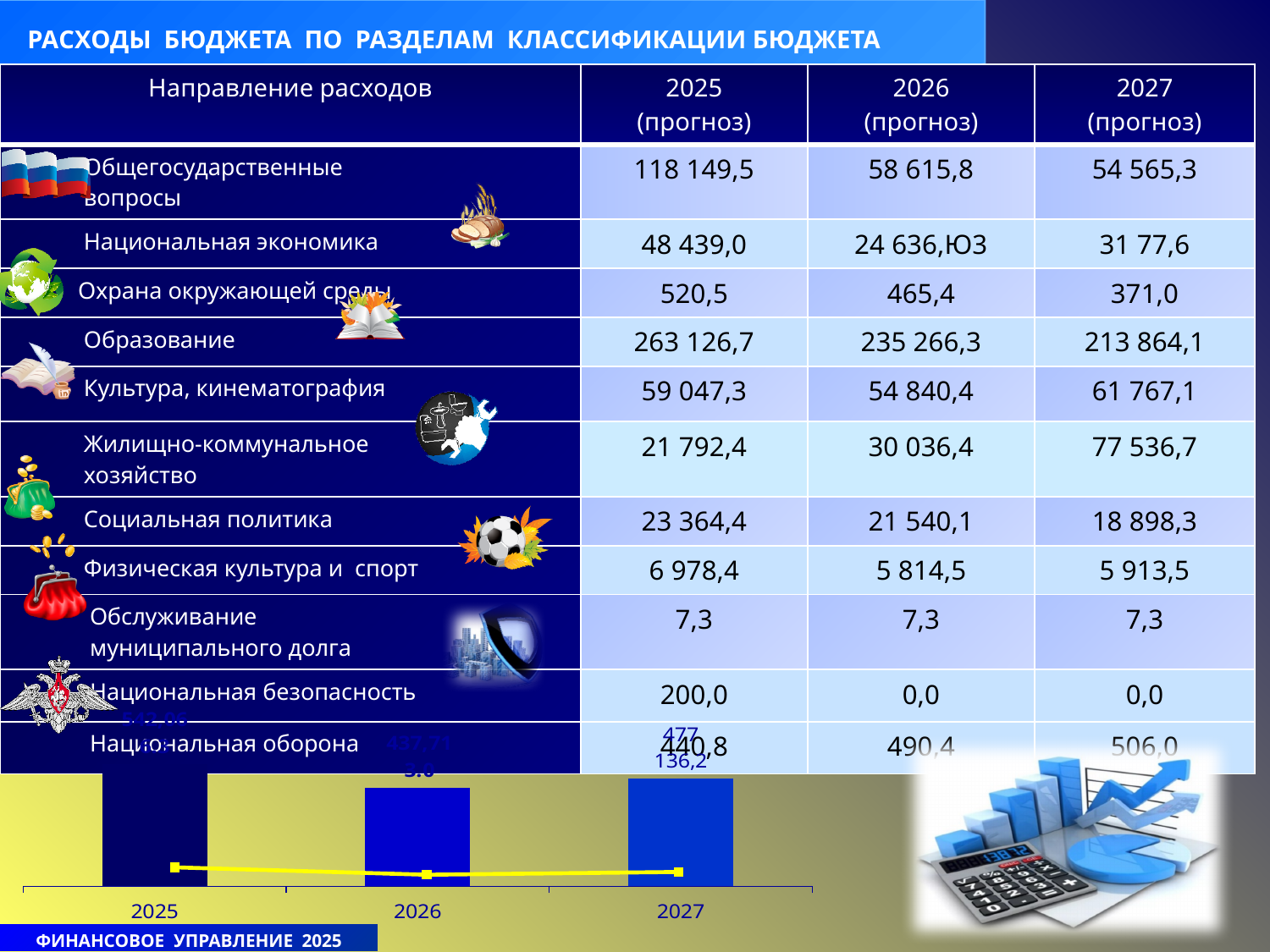
What colour are the bars in the chart at the bottom of the slide? blue In the chart at the bottom of the slide, which category has the tallest bar? 2025 In the chart at the bottom of the slide, does the yellow line rise or fall from 2025 to 2026? fall In the chart at the bottom of the slide, is the bar for 2025 taller or shorter than the bar for 2027? taller How many categories are shown on the x axis of the chart at the bottom of the slide? 3 What are the category labels on the x axis of the chart at the bottom of the slide? 2025, 2026, 2027 What kind of chart is shown at the bottom of the slide? bar chart